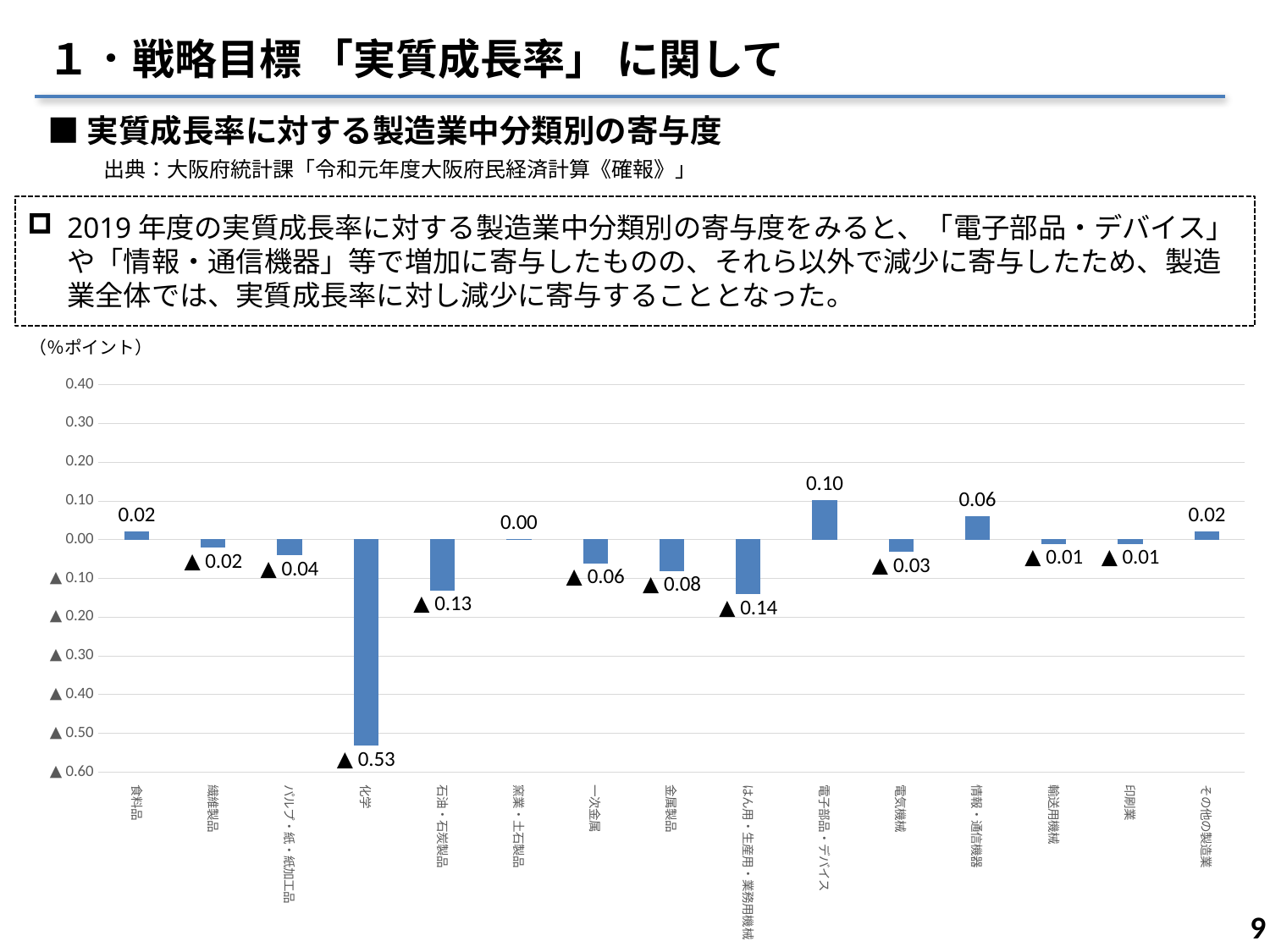
Which category has the lowest value? 化学 What is the difference between the values for 電子部品・デバイス and 情報・通信機器? 0.04 How many categories are shown on the x axis? 15 What is the value for 化学? ▲ 0.53 What is the value for 電子部品・デバイス? 0.10 What is the value for 情報・通信機器? 0.06 What is the value for 窯業・土石製品? 0.00 What kind of chart is this? Bar chart Which is larger, the value for 石油・石炭製品 or the value for 金属製品? 金属製品 What is the value for はん用・生産用・業務用機械? ▲ 0.14 What unit is shown above the chart's y axis? %ポイント Which category has the highest value? 電子部品・デバイス